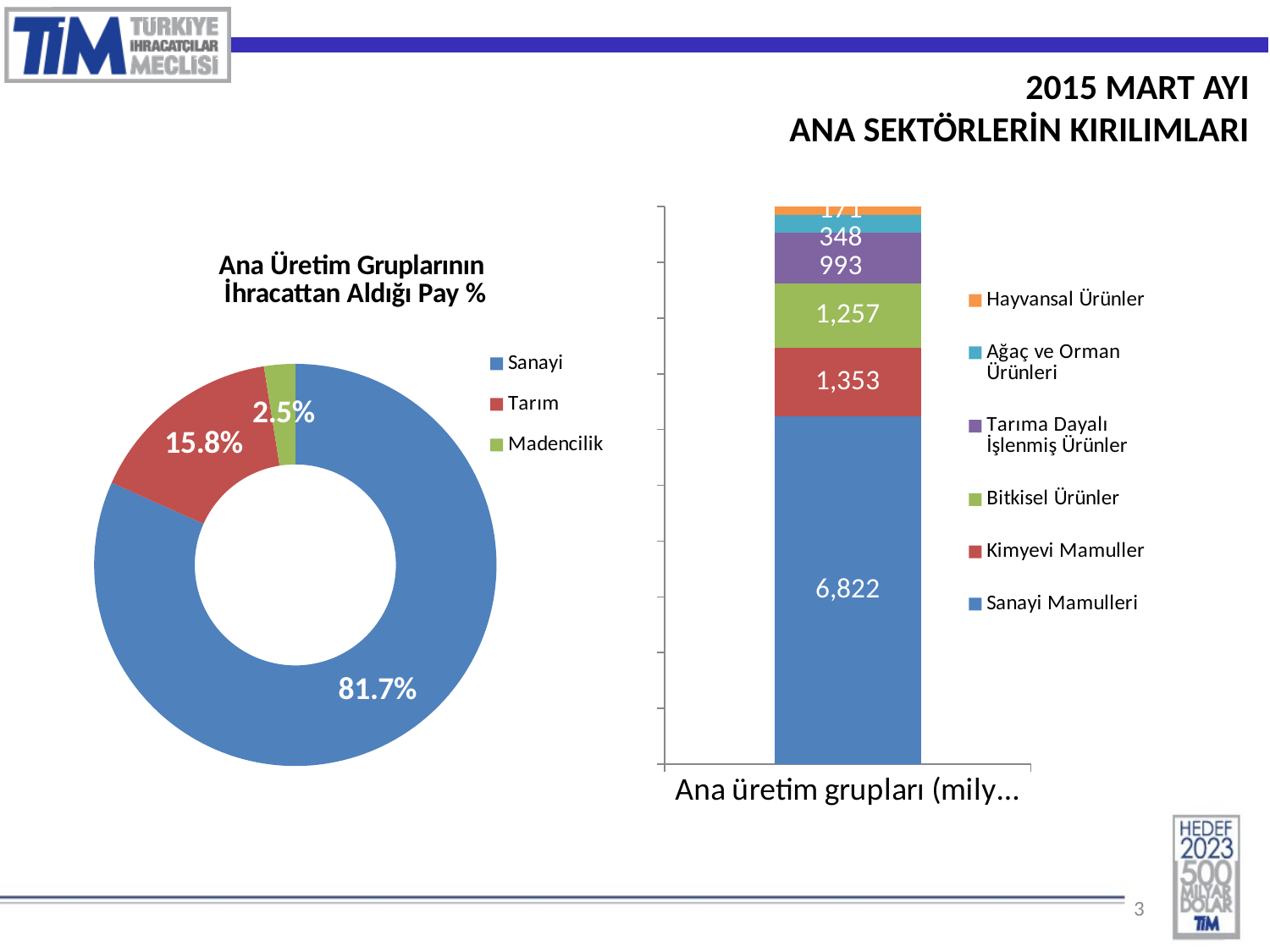
How many series does the legend of the stacked bar chart on the right list? 6 How many categories does the legend of the doughnut chart on the left list? 3 In the doughnut chart titled 'Ana Üretim Gruplarının İhracattan Aldığı Pay %', what share does Sanayi have? 81.7% In the doughnut chart on the left, what share does Madencilik have? 2.5% In the doughnut chart on the left, which category has the largest share? Sanayi In the stacked bar chart on the right, what is the value for Sanayi Mamulleri? 6,822 In the doughnut chart on the left, what is the difference between the shares of Tarım and Madencilik? 13.3% In the stacked bar chart on the right, what is the value for Bitkisel Ürünler? 1,257 In the doughnut chart on the left, what share does Tarım have? 15.8% In the stacked bar chart on the right, what is the value for Kimyevi Mamuller? 1,353 In the stacked bar chart on the right, what is the difference between Kimyevi Mamuller and Bitkisel Ürünler? 96 In the doughnut chart on the left, which category has the smallest share? Madencilik